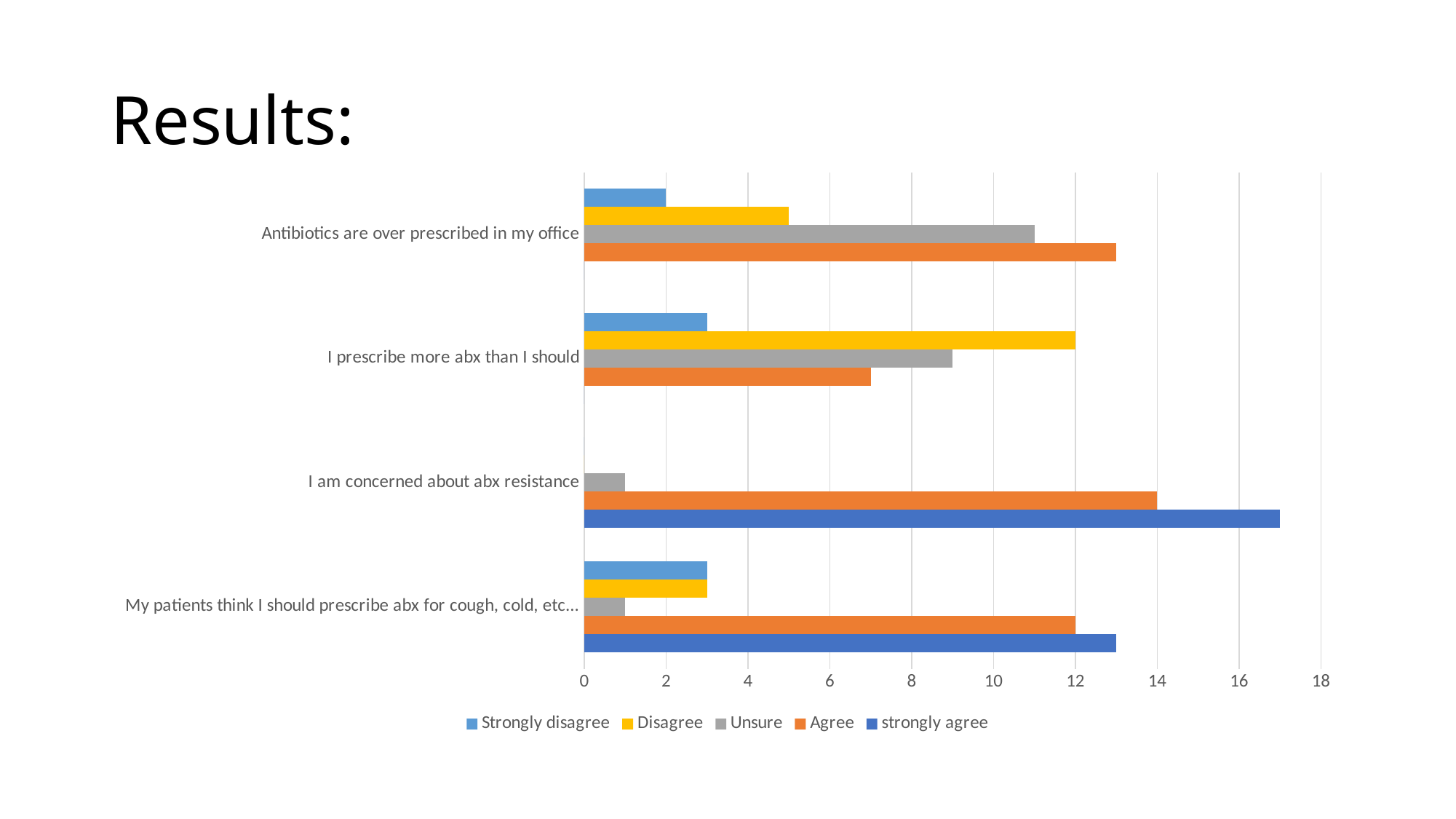
For 'I prescribe more abx than I should', which is larger: the Disagree value or the Agree value? Disagree Which series is shown in orange in the legend? Agree What is the Strongly disagree value for 'Antibiotics are over prescribed in my office'? 2 Which statement has the longest strongly agree bar? I am concerned about abx resistance How many statement categories are shown on the chart? 4 What is the Disagree value for 'I prescribe more abx than I should'? 12 What kind of chart is shown on the slide? bar chart How many series does the legend list? 5 What is the Agree value for 'I am concerned about abx resistance'? 14 Is the Unsure value for 'Antibiotics are over prescribed in my office' greater or less than 10? greater Is the strongly agree value for 'I am concerned about abx resistance' greater or less than 16? greater What is the Agree value for 'My patients think I should prescribe abx for cough, cold, etc...'? 12